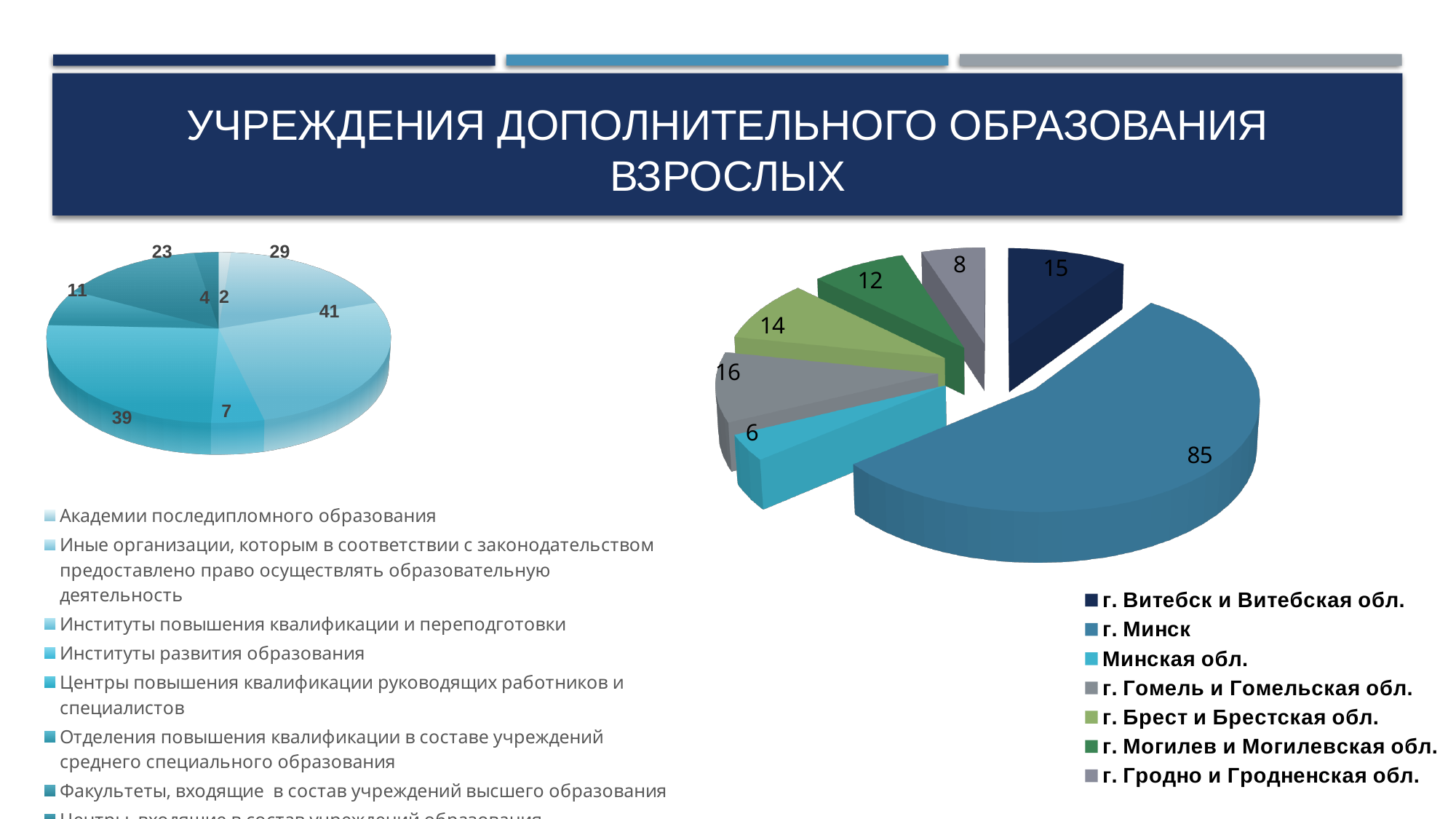
In the right-hand pie chart, what is the value for Минская обл.? 6 What kind of chart is the chart on the right side of the slide? pie chart In the right-hand pie chart, what is the difference between the values for г. Витебск и Витебская обл. and г. Гродно и Гродненская обл.? 7 In the left-hand pie chart, what is the largest value shown on a slice? 41 In the right-hand pie chart, which region has the largest slice? г. Минск What is the title of the slide? УЧРЕЖДЕНИЯ ДОПОЛНИТЕЛЬНОГО ОБРАЗОВАНИЯ ВЗРОСЛЫХ How many slices does the left-hand pie chart have? 8 In the right-hand pie chart, which is larger: г. Брест и Брестская обл. or г. Могилев и Могилевская обл.? г. Брест и Брестская обл. How many entries does the legend of the right-hand pie chart list? 7 In the right-hand pie chart, what is the value for г. Гомель и Гомельская обл.? 16 In the right-hand pie chart, which region has the smallest slice? Минская обл. In the right-hand pie chart, what is the value for г. Минск? 85